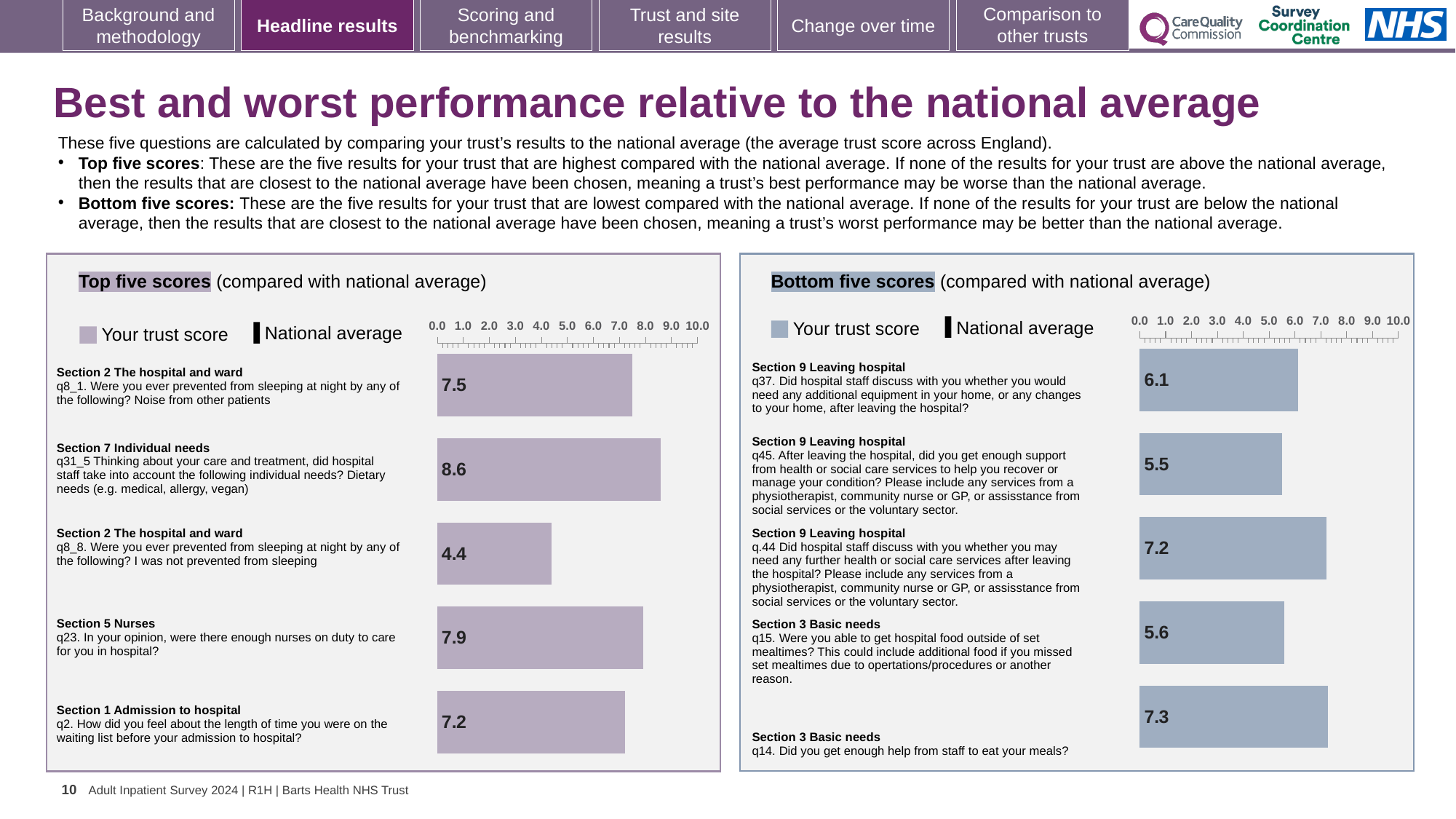
In the Top five scores chart, which question has the highest trust score? q31_5 (dietary needs) In the Bottom five scores chart, which has the larger trust score: q37 or q.44? q.44 In the Top five scores chart, which question has the lowest trust score? q8_8 (I was not prevented from sleeping) How many questions are shown in the Bottom five scores chart? 5 In the Bottom five scores chart, what is the trust score for q14 (enough help from staff to eat meals)? 7.3 How many series does the legend of the Top five scores chart list? 2 What type of chart is used for the Top five scores? Bar chart In the Top five scores chart, what is the difference between the trust scores for q31_5 and q8_8? 4.2 In the Top five scores chart, what is the trust score for q31_5 (dietary needs)? 8.6 In the Bottom five scores chart, which question has the lowest trust score? q45 (support from health or social care services after leaving hospital) In the Top five scores chart, what is the trust score for q23 (enough nurses on duty)? 7.9 In the Bottom five scores chart, what is the trust score for q45 (support from health or social care services after leaving hospital)? 5.5